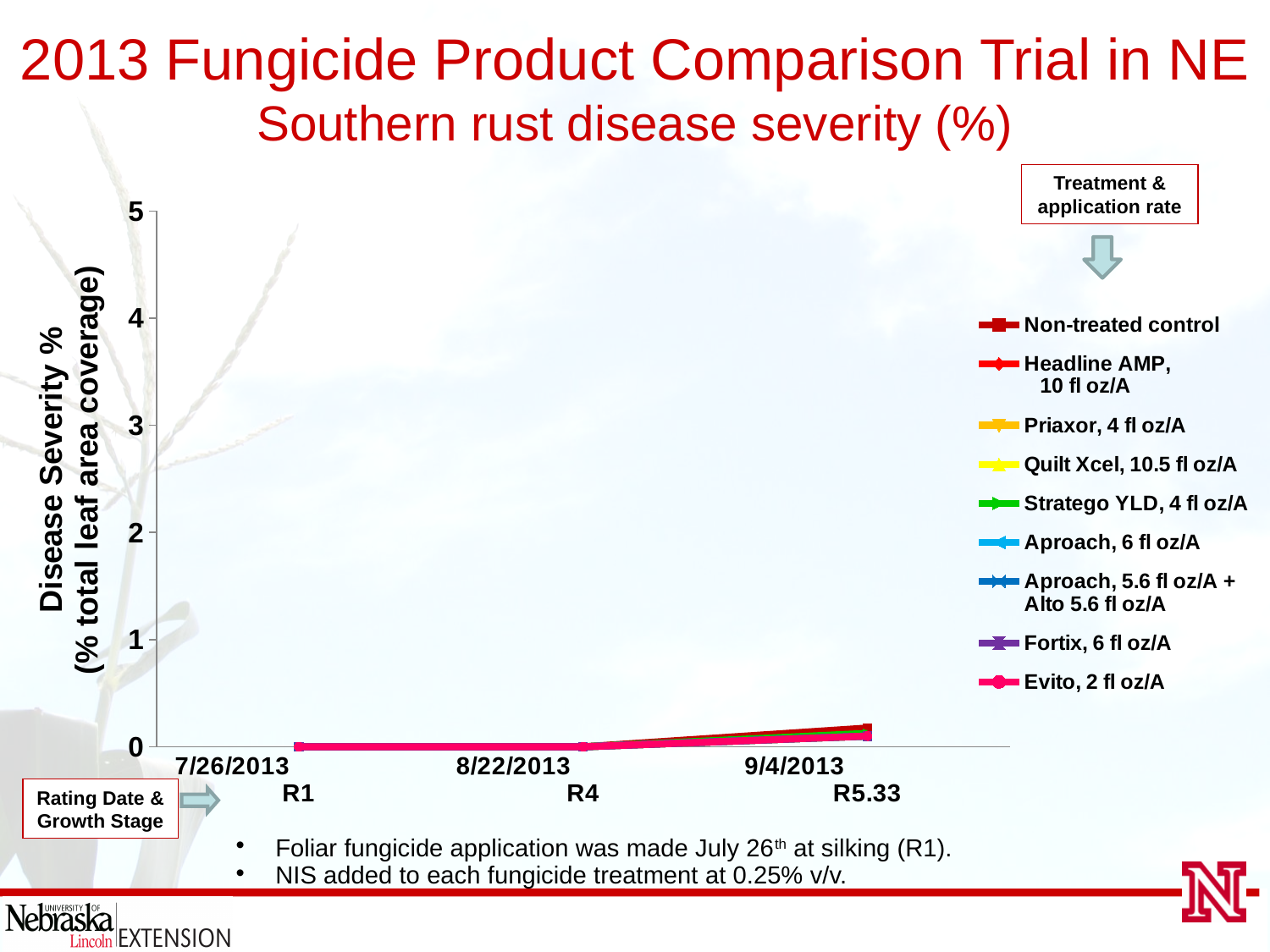
What is the highest value shown on the y axis? 5 Is the disease severity for Headline AMP, 10 fl oz/A on 7/26/2013 greater or less than 1? less Do the disease severity values rise or fall from 8/22/2013 to 9/4/2013? rise Which growth stage is shown under the rating date 9/4/2013? R5.33 Is the disease severity for the Non-treated control on 9/4/2013 greater or less than 1? less What kind of chart is shown on the slide? line chart What is the application rate listed in the legend for Quilt Xcel? 10.5 fl oz/A Which growth stage is shown under the rating date 7/26/2013? R1 How many series does the legend list? 9 How many rating dates are shown on the x axis? 3 Is the disease severity for Evito, 2 fl oz/A on 9/4/2013 greater or less than 1? less